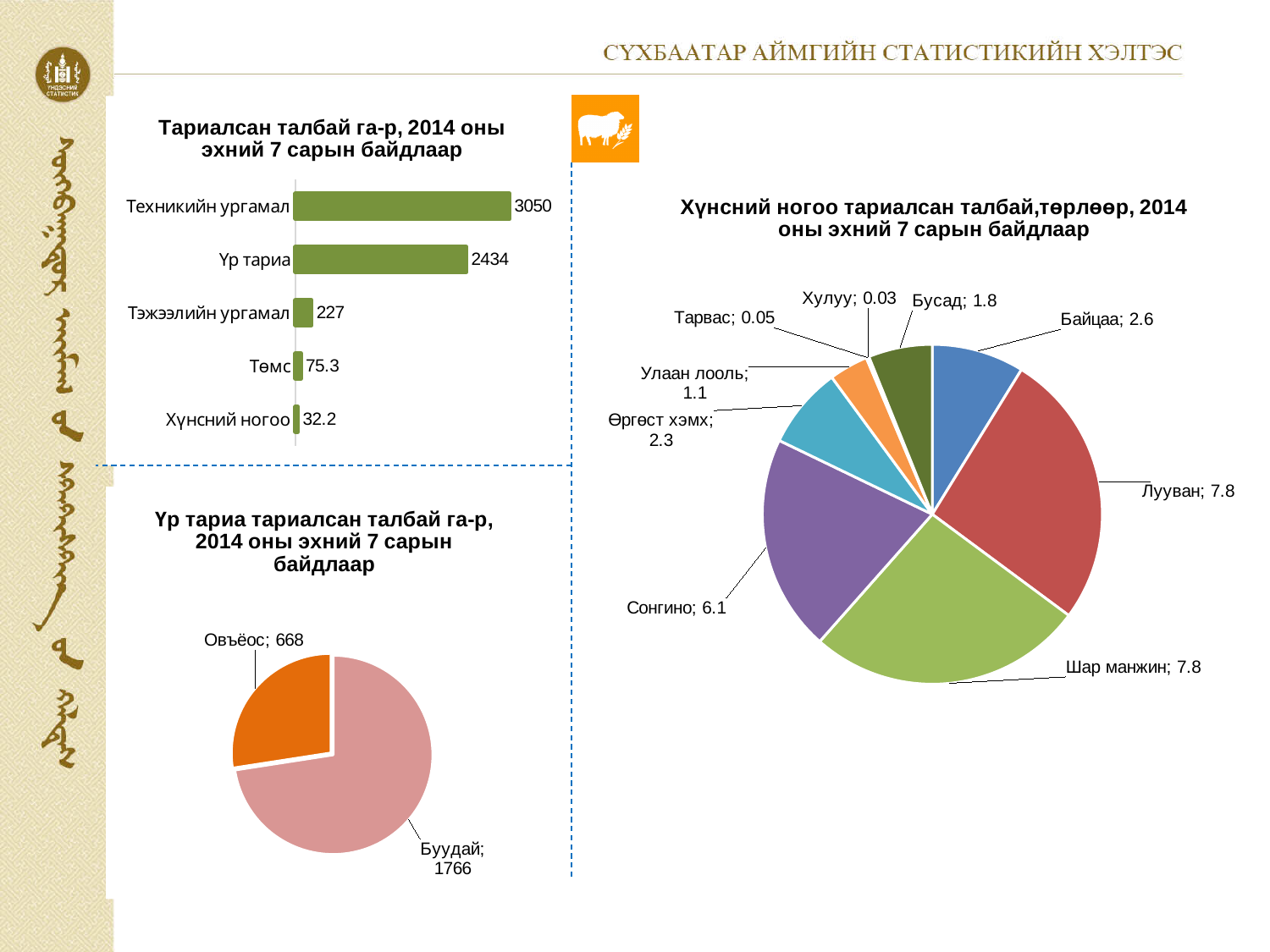
In the bar chart 'Тариалсан талбай га-р, 2014 оны эхний 7 сарын байдлаар', which category has the highest value? Техникийн ургамал In the pie chart 'Хүнсний ногоо тариалсан талбай, төрлөөр, 2014 оны эхний 7 сарын байдлаар', which is larger, Байцаа or Өргөст хэмх? Байцаа In the bar chart 'Тариалсан талбай га-р, 2014 оны эхний 7 сарын байдлаар', which category has the lowest value? Хүнсний ногоо In the pie chart 'Хүнсний ногоо тариалсан талбай, төрлөөр, 2014 оны эхний 7 сарын байдлаар', how many slices are there? 9 In the bar chart 'Тариалсан талбай га-р, 2014 оны эхний 7 сарын байдлаар', how many categories are shown? 5 In the pie chart 'Хүнсний ногоо тариалсан талбай, төрлөөр, 2014 оны эхний 7 сарын байдлаар', which category has the smallest value? Хулуу In the bar chart 'Тариалсан талбай га-р, 2014 оны эхний 7 сарын байдлаар', what is the difference between Техникийн ургамал and Үр тариа? 616 In the pie chart 'Үр тариа тариалсан талбай га-р, 2014 оны эхний 7 сарын байдлаар', what share of the total does Буудай represent? 72.6% In the pie chart 'Хүнсний ногоо тариалсан талбай, төрлөөр, 2014 оны эхний 7 сарын байдлаар', what is the value for Сонгино? 6.1 In the bar chart 'Тариалсан талбай га-р, 2014 оны эхний 7 сарын байдлаар', what is the value for Үр тариа? 2434 In the pie chart 'Үр тариа тариалсан талбай га-р, 2014 оны эхний 7 сарын байдлаар', what is the value for Овъёос? 668 What type of chart is the top-left chart 'Тариалсан талбай га-р, 2014 оны эхний 7 сарын байдлаар'? Bar chart